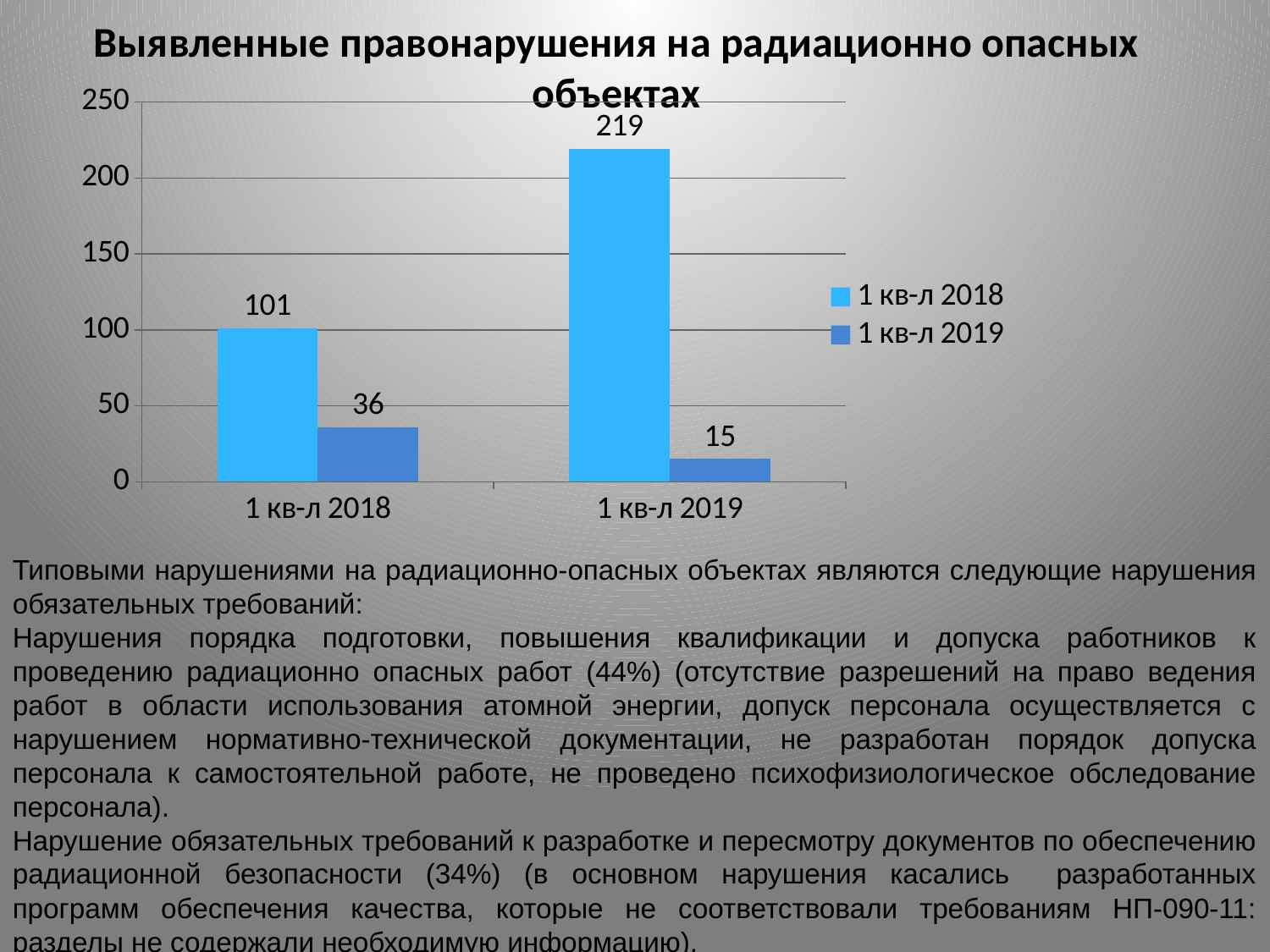
What type of chart is shown on the slide? bar chart How many categories are shown on the x axis? 2 What is the value of the dark blue series (1 кв-л 2019) for the category 1 кв-л 2018? 36 What is the value of the light blue series (1 кв-л 2018) for the category 1 кв-л 2019? 219 What is the value of the light blue series (1 кв-л 2018) for the category 1 кв-л 2018? 101 What is the value of the dark blue series (1 кв-л 2019) for the category 1 кв-л 2019? 15 Which bar has the lowest value in the chart? 15 (dark blue series, category 1 кв-л 2019) What is the difference between the light blue bars for 1 кв-л 2019 and 1 кв-л 2018? 118 Which bar has the highest value in the chart? 219 (light blue series, category 1 кв-л 2019) What is the title of the chart? Выявленные правонарушения на радиационно опасных объектах How many series does the legend list? 2 Which is larger: the dark blue bar for 1 кв-л 2018 or the dark blue bar for 1 кв-л 2019? 1 кв-л 2018